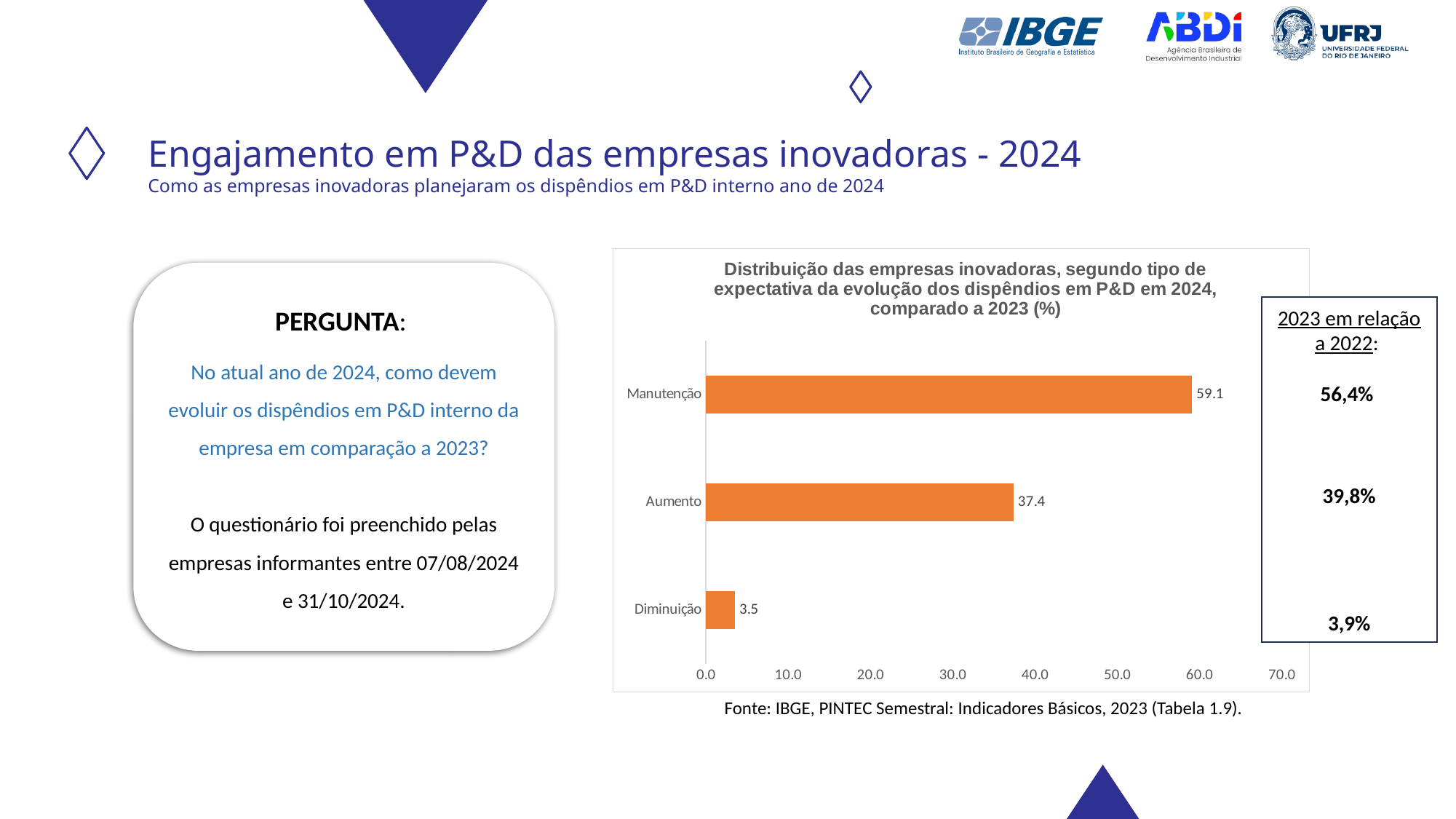
What is the maximum value shown on the x axis of the chart? 70.0 What is the difference between the values for Aumento and Diminuição? 33.9 Is the value for Manutenção greater or less than 50.0? greater How many categories are shown in the chart? 3 What is the value for Diminuição? 3.5 Which category has the highest value? Manutenção What is the difference between the values for Manutenção and Aumento? 21.7 What is the value for Manutenção? 59.1 Which is larger, the value for Aumento or the value for Diminuição? Aumento What is the value for Aumento? 37.4 What kind of chart is shown on the slide? bar chart Which category has the lowest value? Diminuição